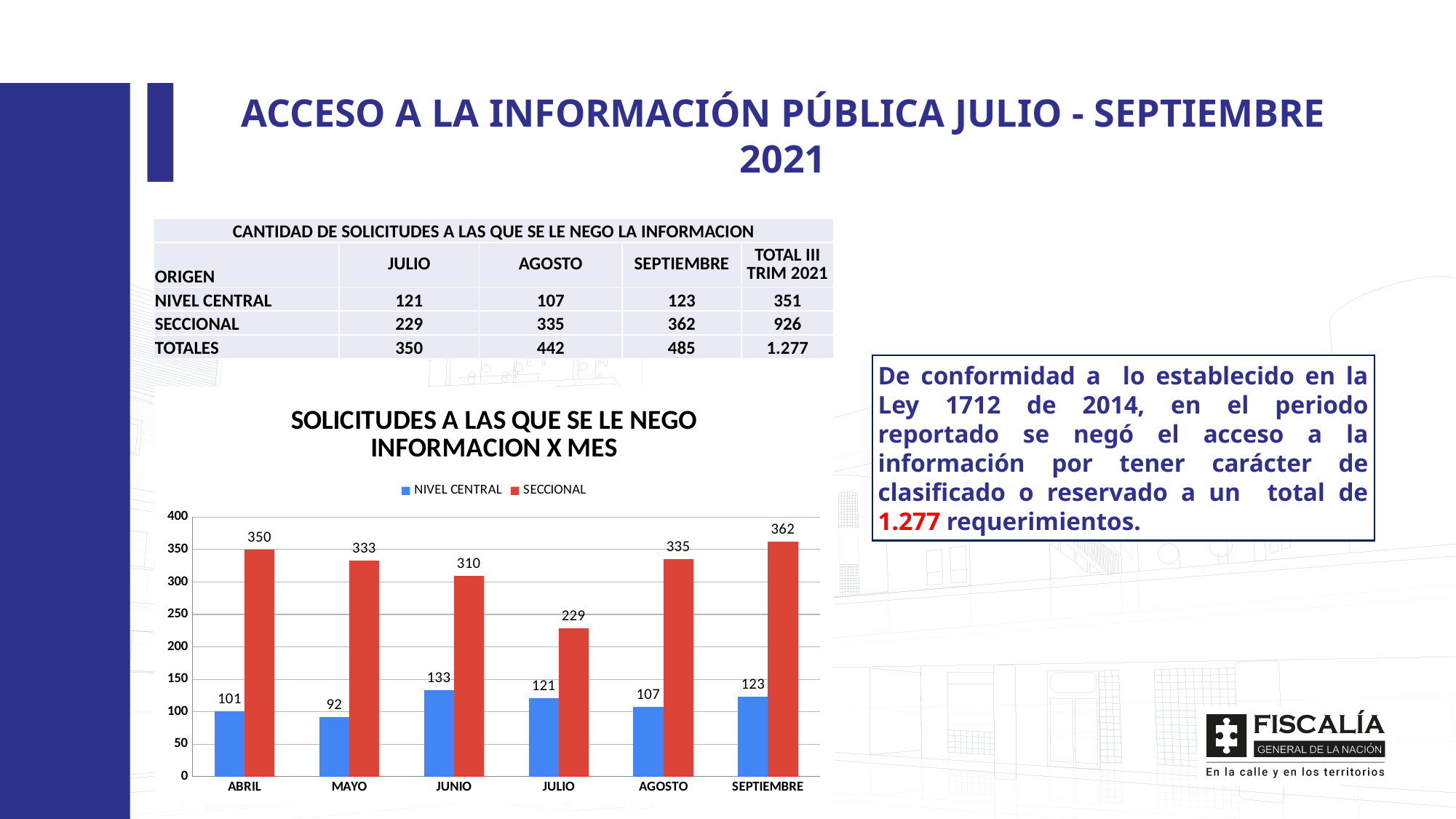
Which month has the highest SECCIONAL value? SEPTIEMBRE What kind of chart is shown on the slide? bar chart What is the title of the chart? SOLICITUDES A LAS QUE SE LE NEGO INFORMACION X MES What is the value for SECCIONAL in SEPTIEMBRE? 362 What is the value for NIVEL CENTRAL in ABRIL? 101 What is the difference between the SECCIONAL and NIVEL CENTRAL values in AGOSTO? 228 How many months are shown on the x axis of the chart? 6 Is the SECCIONAL value for JULIO greater or less than 250? less What is the value for SECCIONAL in JULIO? 229 How many series does the chart legend list? 2 Which month has the lowest NIVEL CENTRAL value? MAYO Which is larger, the SECCIONAL value in ABRIL or in MAYO? ABRIL